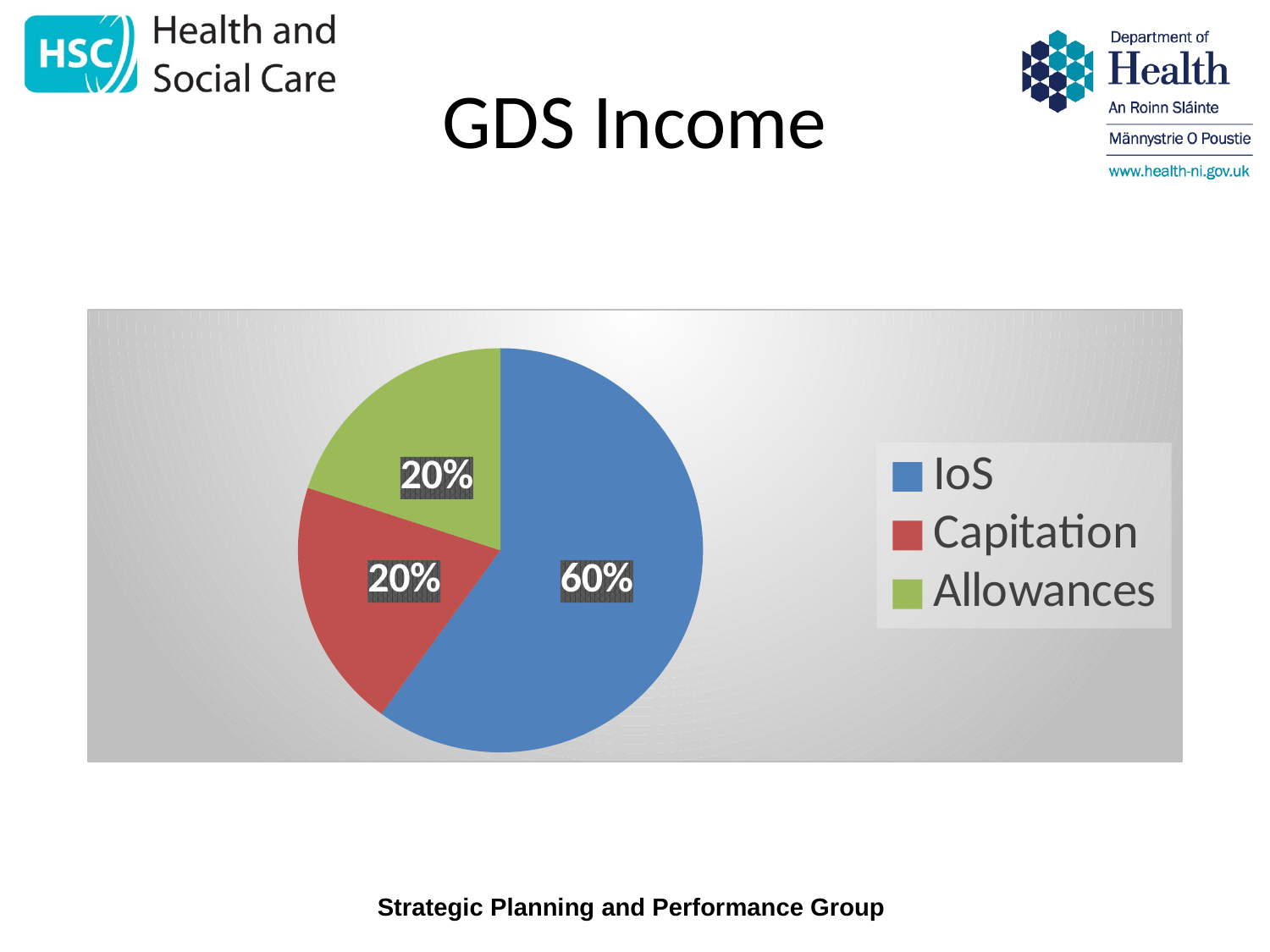
What is the difference in percentage points between the IoS share and the Capitation share? 40 Which is larger, the IoS share or the Allowances share? IoS What share of GDS Income does Allowances account for? 20% What colour is the Capitation slice in the pie chart? red How many categories does the legend list? 3 What kind of chart is shown on the slide? pie chart What share of GDS Income does Capitation account for? 20% How many slices does the pie chart have? 3 What is the title of the slide containing the pie chart? GDS Income Which category has the largest share of the pie? IoS What share of GDS Income does IoS account for? 60% Is the share for IoS greater or less than 50%? greater